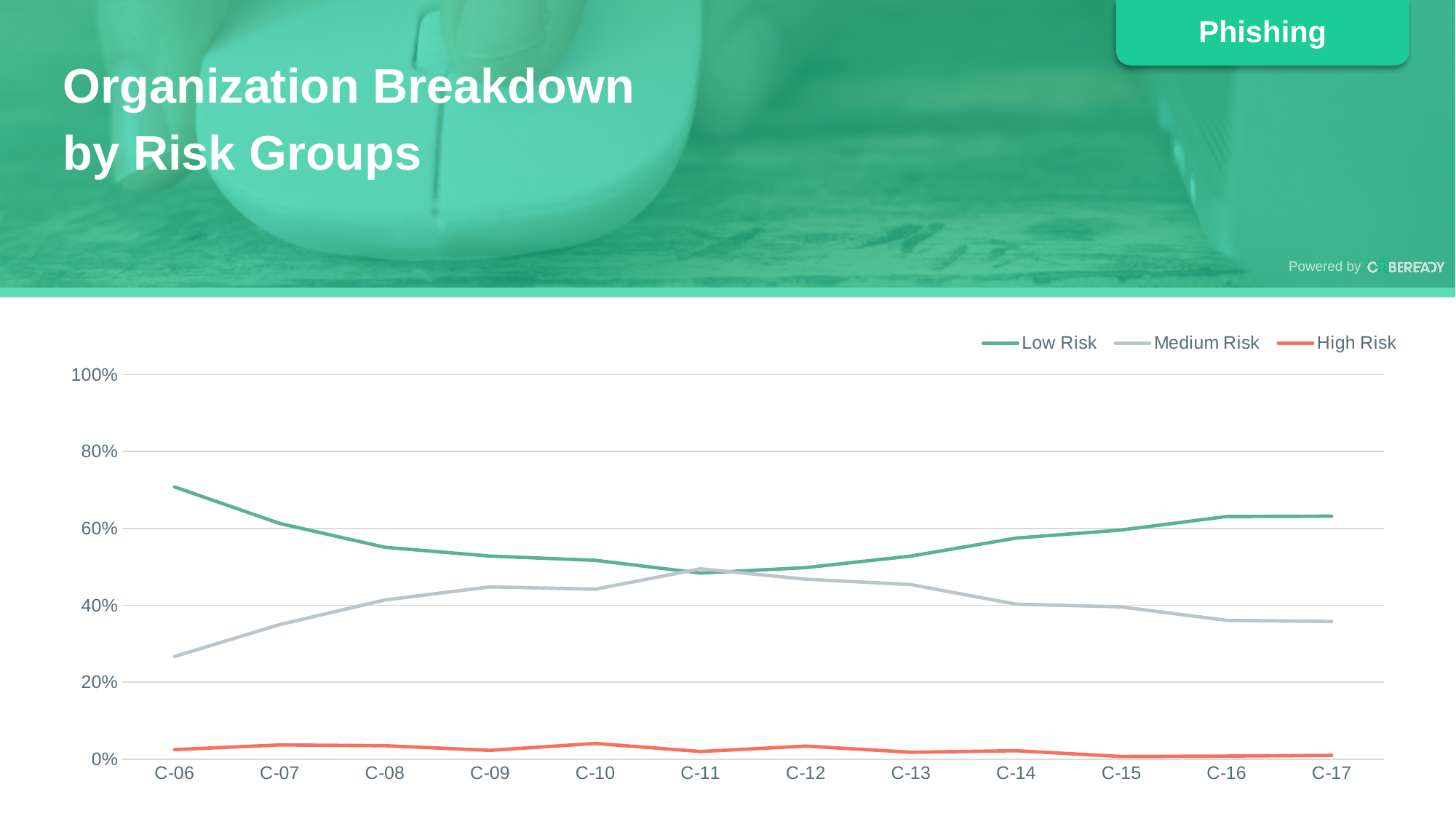
What kind of chart is shown on the slide? line chart At which category is the Low Risk series highest? C-06 Does the Medium Risk series rise or fall from C-06 to C-11? rise Which series is drawn in red? High Risk How many categories are shown on the x axis? 12 Is the Medium Risk value at C-06 greater or less than 40%? less At which category is the Medium Risk series lowest? C-06 Is the High Risk value at C-15 greater or less than 20%? less Is the Low Risk value at C-06 greater or less than 60%? greater At C-17, which is larger: Low Risk or Medium Risk? Low Risk Does the Low Risk series rise or fall from C-06 to C-11? fall How many series does the legend list? 3